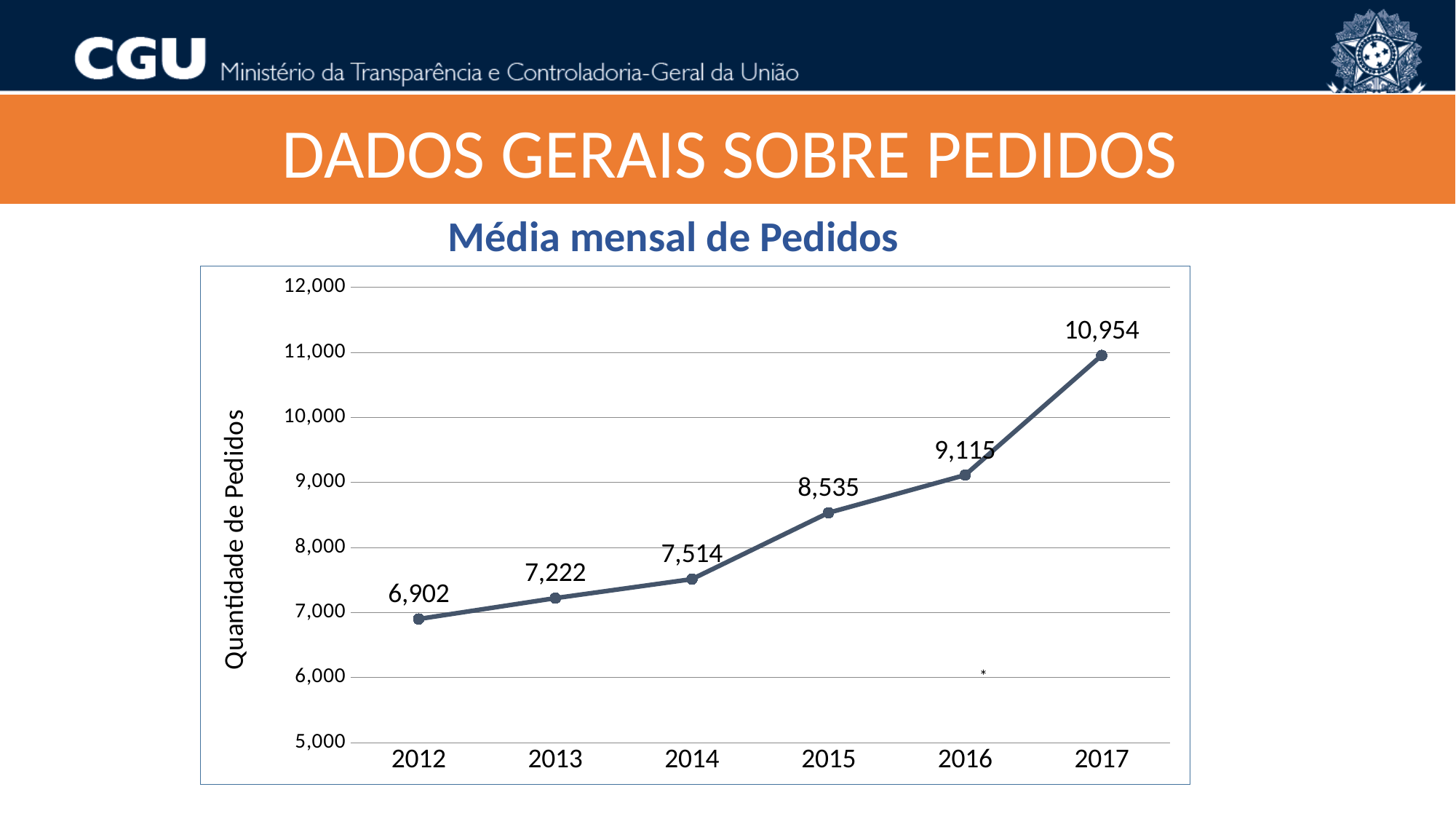
What is the difference between the 2014 value and the 2013 value in the Média mensal de Pedidos chart? 292 What is the average monthly number of requests (Média mensal de Pedidos) for 2012? 6,902 What is the difference between the 2017 value and the 2016 value in the Média mensal de Pedidos chart? 1,839 What value is shown for 2015 in the Média mensal de Pedidos chart? 8,535 Is the value for 2016 greater or less than 9,000? greater What kind of chart is used to show Média mensal de Pedidos? Line chart Which year has a larger value, 2014 or 2015? 2015 Which year has the lowest value in the Média mensal de Pedidos chart? 2012 Which year has the highest value in the Média mensal de Pedidos chart? 2017 How many years are plotted in the Média mensal de Pedidos chart? 6 What value is shown for 2017 in the Média mensal de Pedidos chart? 10,954 Do the values in the Média mensal de Pedidos chart rise or fall from 2012 to 2017? Rise